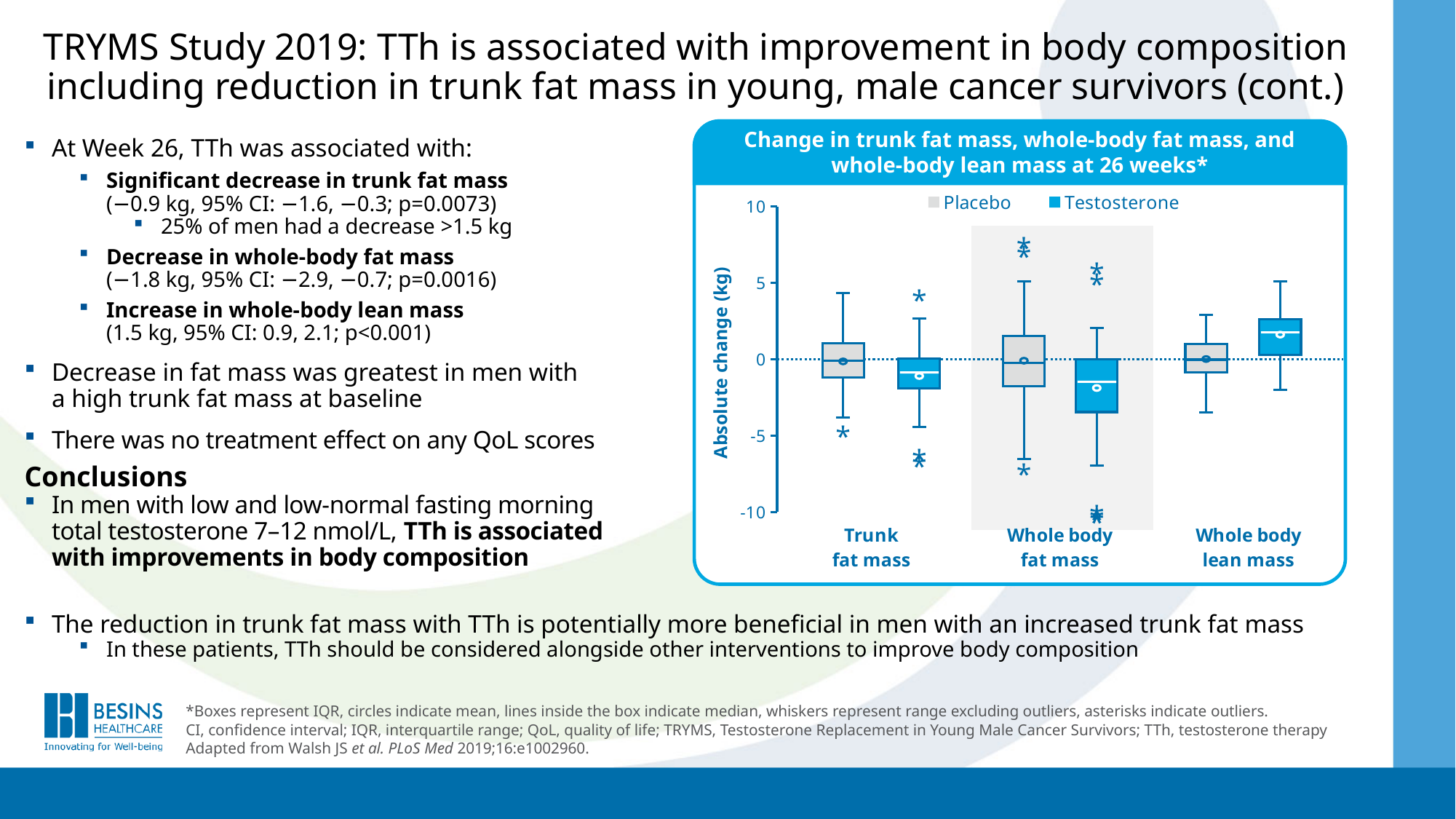
Is the median value for Testosterone in the Whole body fat mass category greater or less than 0? less What kind of chart is shown on the slide? box plot How many categories are shown along the x axis of the chart? 3 Is the median value for Testosterone in the Whole body lean mass category greater or less than 0? greater What are the two series named in the chart legend? Placebo and Testosterone Which category shows the highest median for the Testosterone series? Whole body lean mass How many series does the chart legend list? 2 In the Whole body fat mass category, which series has the lower median: Placebo or Testosterone? Testosterone What is the label of the vertical axis of the chart? Absolute change (kg) Is the median value for Testosterone in the Whole body lean mass category greater or less than 5? less In the Whole body lean mass category, which series has the higher median: Placebo or Testosterone? Testosterone